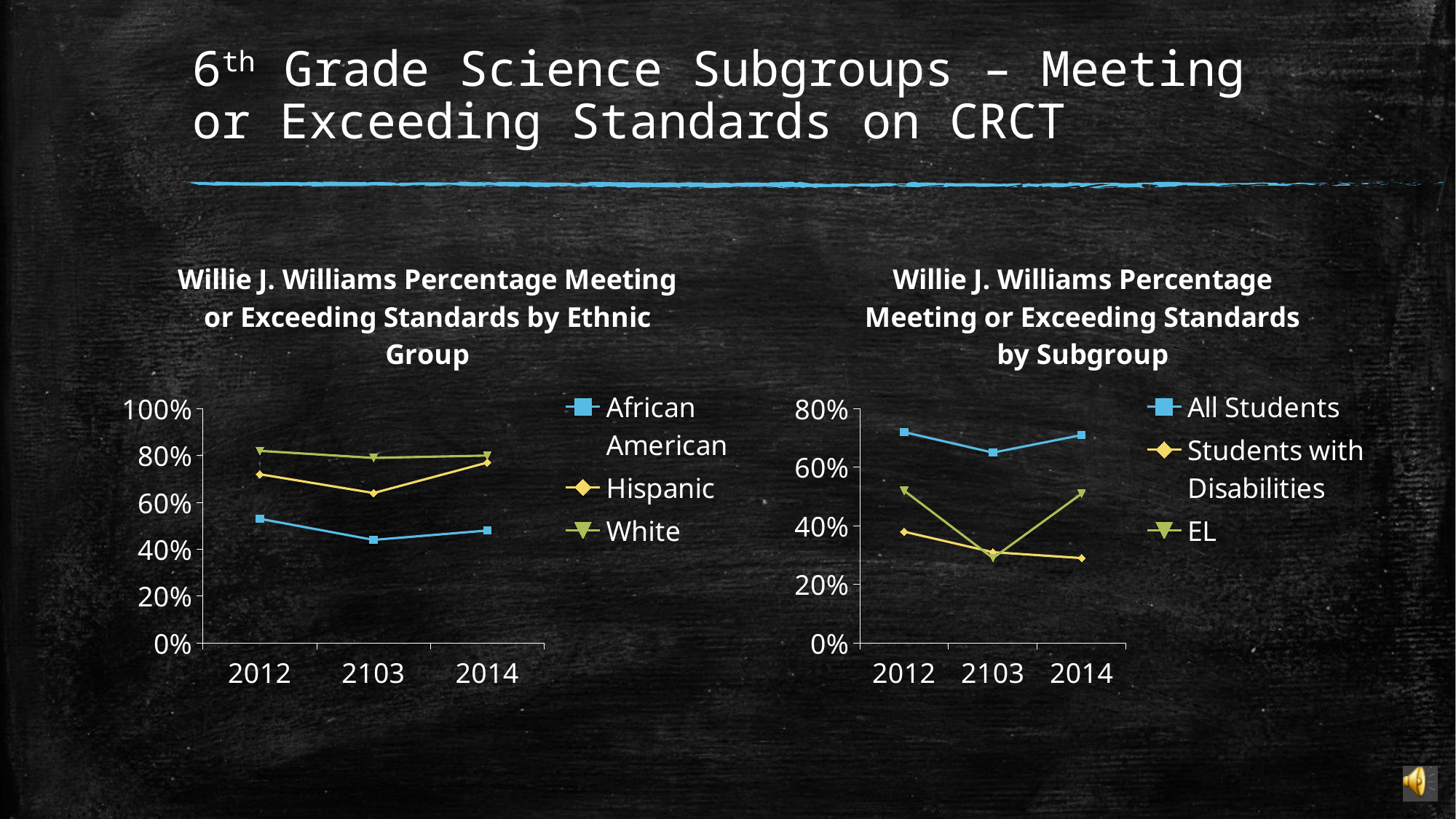
In the left chart (by Ethnic Group), which is larger in 2014: Hispanic or African American? Hispanic How many points are on the x axis of the left chart (by Ethnic Group)? 3 What kind of chart is the left chart, 'Willie J. Williams Percentage Meeting or Exceeding Standards by Ethnic Group'? line chart In the right chart (by Subgroup), which series has the lowest value in 2014? Students with Disabilities In the left chart (by Ethnic Group), which series has the highest value in 2012? White In the right chart (by Subgroup), does the EL series rise or fall from 2103 to 2014? rise How many series does the legend of the left chart (by Ethnic Group) list? 3 In the left chart (by Ethnic Group), is the value for African American in 2012 greater or less than 60%? less In the left chart (by Ethnic Group), does the African American series rise or fall from 2012 to 2103? fall In the right chart (by Subgroup), is the value for All Students in 2012 greater or less than 60%? greater How many series does the legend of the right chart (by Subgroup) list? 3 In the left chart (by Ethnic Group), is the value for Hispanic in 2103 greater or less than 80%? less